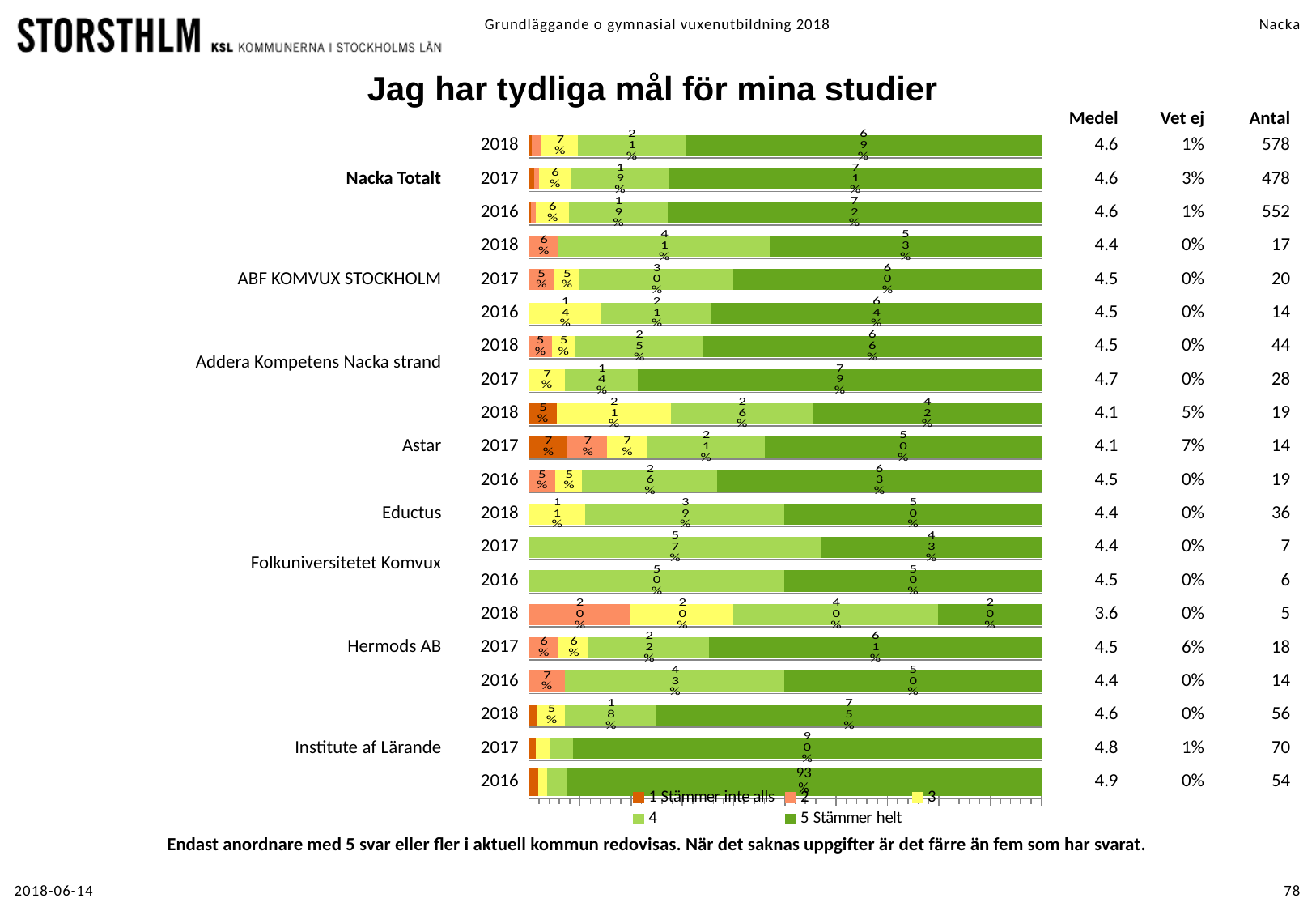
In the Folkuniversitetet Komvux 2017 bar, which is larger: the '4' segment or the '5 Stämmer helt' segment? 4 Which legend entry is shown in the darkest green colour? 5 Stämmer helt In the Nacka Totalt 2018 bar, how many percentage points larger is the '5 Stämmer helt' segment than the '4' segment? 48 percentage points What is the title of the chart? Jag har tydliga mål för mina studier What kind of chart is shown on the slide? bar chart What percentage of the Institute af Lärande 2016 bar is '5 Stämmer helt'? 93% How many series does the chart legend list? 5 For Institute af Lärande, which year has the highest '5 Stämmer helt' share? 2016 What percentage of the Addera Kompetens Nacka strand 2017 bar is '5 Stämmer helt'? 79% What percentage of the Nacka Totalt 2018 bar is '5 Stämmer helt'? 69% What percentage of the Eductus 2018 bar is category '3'? 11% What percentage of the Hermods AB 2018 bar is category '4'? 40%